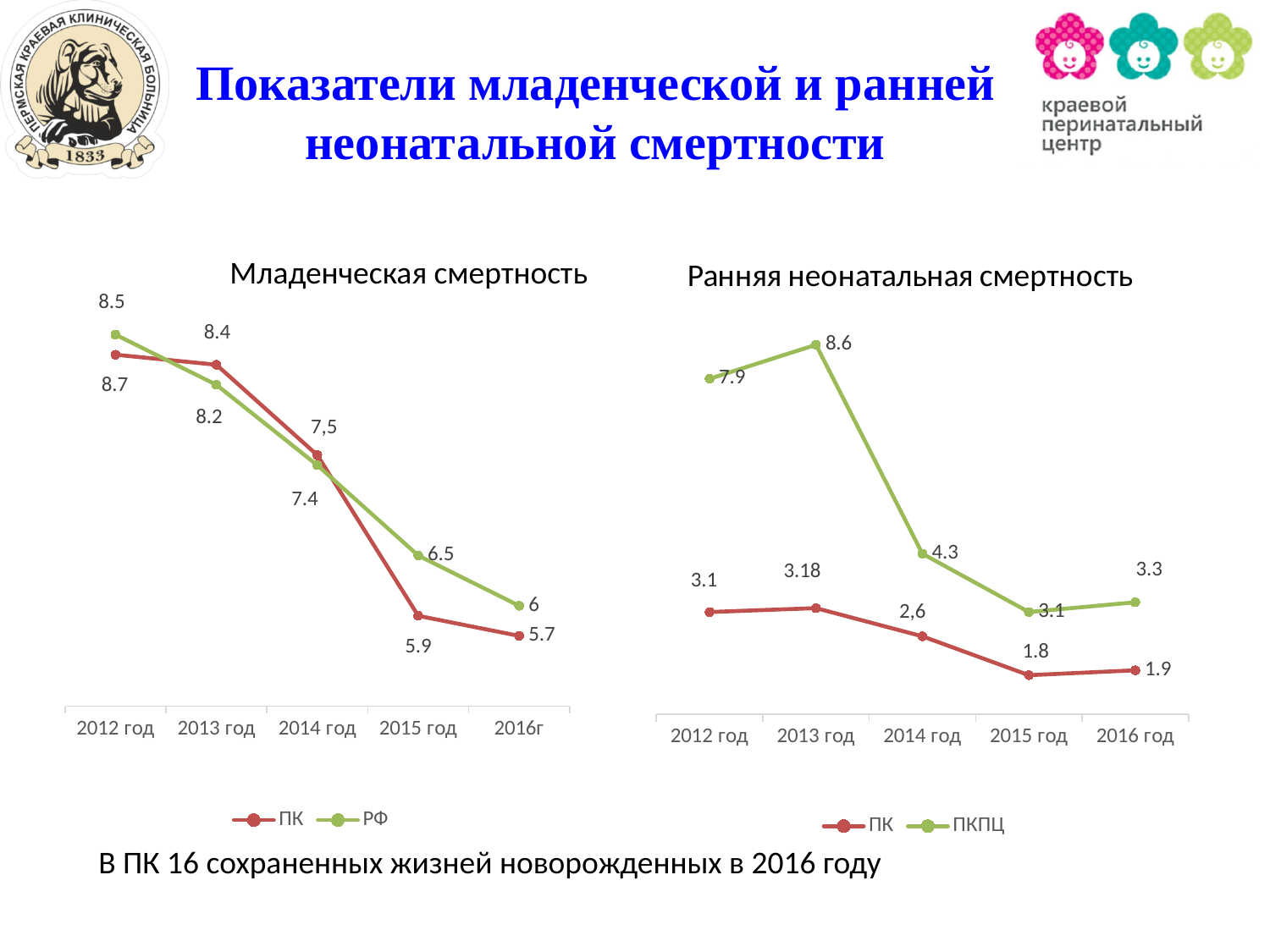
On the chart titled 'Ранняя неонатальная смертность', in which year is the ПК value lowest? 2015 год On the chart titled 'Ранняя неонатальная смертность', what is the difference between the ПКПЦ and ПК values in 2014 год? 1.7 On the chart titled 'Младенческая смертность', what is the value for ПК in 2016г? 5.7 On the chart titled 'Ранняя неонатальная смертность', how many series does the legend list? 2 On the chart titled 'Младенческая смертность', which series has the larger value in 2015 год, ПК or РФ? РФ What kind of chart is the chart titled 'Ранняя неонатальная смертность'? line chart On the chart titled 'Младенческая смертность', what is the value for РФ in 2015 год? 6.5 On the chart titled 'Ранняя неонатальная смертность', in which year is the ПКПЦ value highest? 2013 год On the chart titled 'Ранняя неонатальная смертность', what is the value for ПК in 2015 год? 1.8 On the chart titled 'Ранняя неонатальная смертность', what is the value for ПКПЦ in 2013 год? 8.6 On the chart titled 'Младенческая смертность', how many years are shown on the x axis? 5 On the chart titled 'Младенческая смертность', does the ПК series rise or fall from 2012 год to 2016г? fall